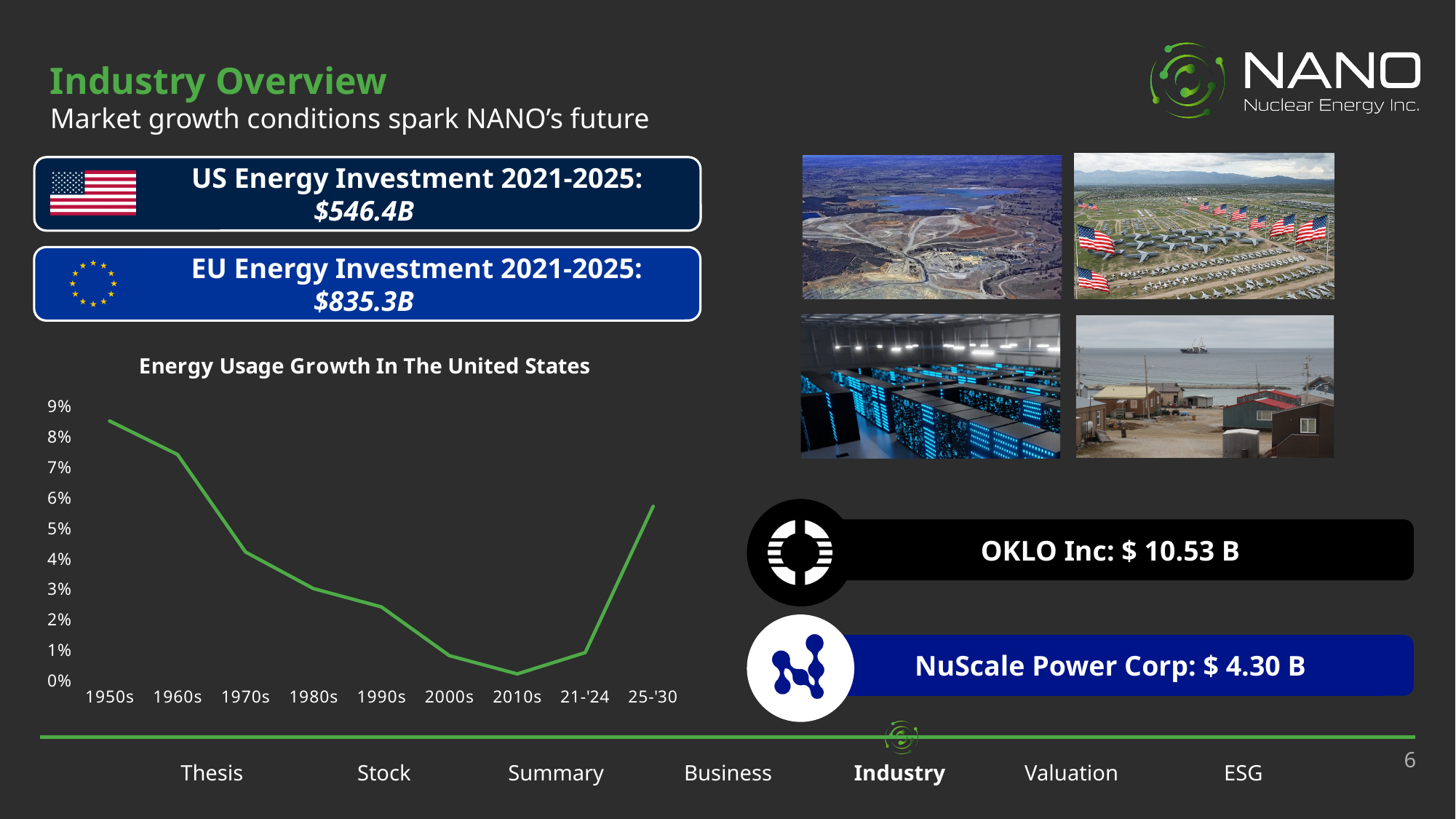
In the Energy Usage Growth In The United States chart, which period has the highest value? 1950s In the Energy Usage Growth In The United States chart, is the value for 25-'30 greater or less than 5%? greater In the Energy Usage Growth In The United States chart, which period has the lowest value? 2010s In the Energy Usage Growth In The United States chart, which is larger, the value for the 1960s or the 1970s? 1960s How many periods are shown on the x axis of the Energy Usage Growth In The United States chart? 9 What kind of chart is "Energy Usage Growth In The United States"? line chart In the Energy Usage Growth In The United States chart, do the values rise or fall from the 1950s to the 2010s? fall In the Energy Usage Growth In The United States chart, is the value for the 2000s greater or less than 2%? less In the Energy Usage Growth In The United States chart, is the value for the 2010s greater or less than 1%? less In the Energy Usage Growth In The United States chart, which is larger, the value for 21-'24 or 25-'30? 25-'30